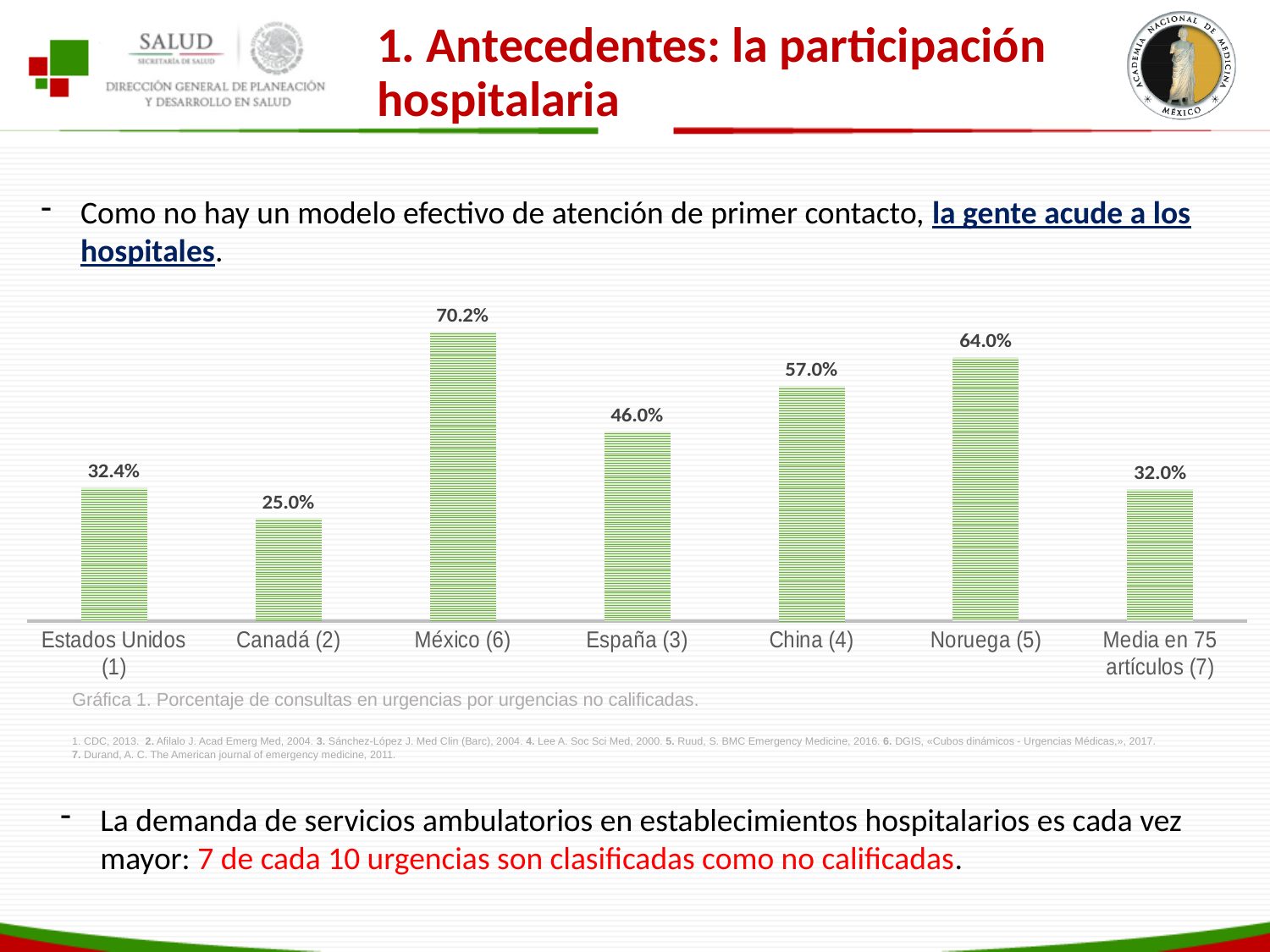
What is the value for México (6)? 70.2% What is the value for Media en 75 artículos (7)? 32.0% Which category has the highest value? México (6) What is the value for Noruega (5)? 64.0% How many categories are shown in the chart? 7 What is the value for Canadá (2)? 25.0% What is the caption of the chart? Gráfica 1. Porcentaje de consultas en urgencias por urgencias no calificadas. What is the difference between the values for México (6) and Canadá (2)? 45.2% Which is larger, the value for España (3) or the value for China (4)? China (4) Which category has the lowest value? Canadá (2) What is the difference between the values for Noruega (5) and China (4)? 7.0% What kind of chart is shown on the slide? Bar chart